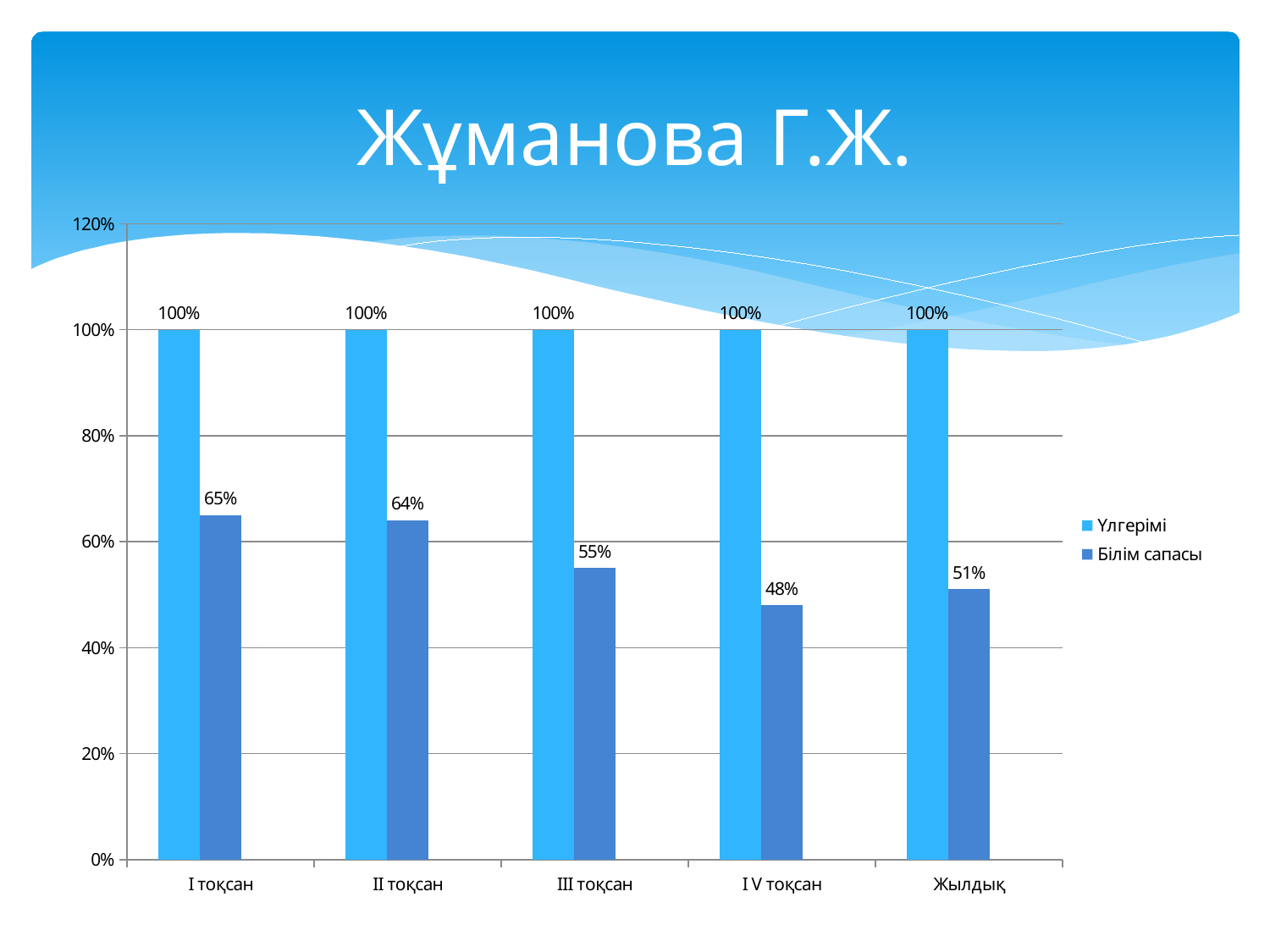
What is the value of Білім сапасы for Жылдық? 51% How many categories are shown on the x axis? 5 How many series does the legend list? 2 Which category has the lowest Білім сапасы value? IV тоқсан What is the difference between the Білім сапасы values for I тоқсан and IV тоқсан? 17% What is the value of Үлгерімі for III тоқсан? 100% What is the value of Білім сапасы for IV тоқсан? 48% What kind of chart is shown on the slide? Bar chart Does the Білім сапасы value rise or fall from I тоқсан to IV тоқсан? Fall Which is larger, the Білім сапасы value for II тоқсан or for III тоқсан? II тоқсан Which category has the highest Білім сапасы value? I тоқсан What is the value of Білім сапасы for I тоқсан? 65%